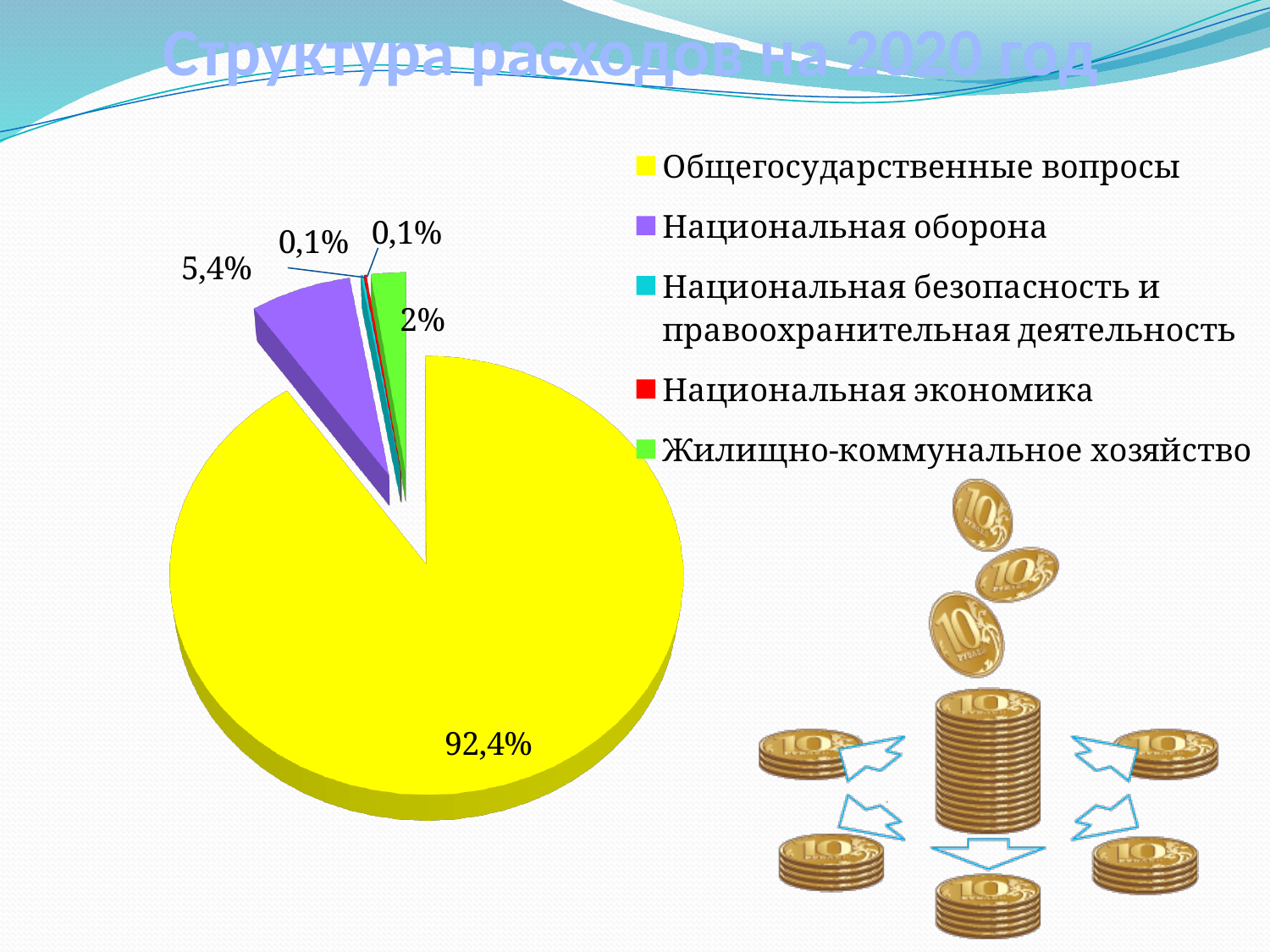
What share of the pie does Общегосударственные вопросы take? 92,4% What is the value shown for Жилищно-коммунальное хозяйство? 2% Which is larger: the slice for Национальная оборона or the slice for Жилищно-коммунальное хозяйство? Национальная оборона What is the value shown for Национальная экономика? 0,1% Which category has the largest slice of the pie? Общегосударственные вопросы How many categories does the legend of the pie chart list? 5 What colour is the slice for Национальная оборона? purple What is the difference between the values for Общегосударственные вопросы and Национальная оборона? 87% What kind of chart is shown on the slide? pie chart What is the value shown for Национальная оборона? 5,4% What is the title of the chart on the slide? Структура расходов на 2020 год What is the difference between the values for Национальная оборона and Жилищно-коммунальное хозяйство? 3,4%